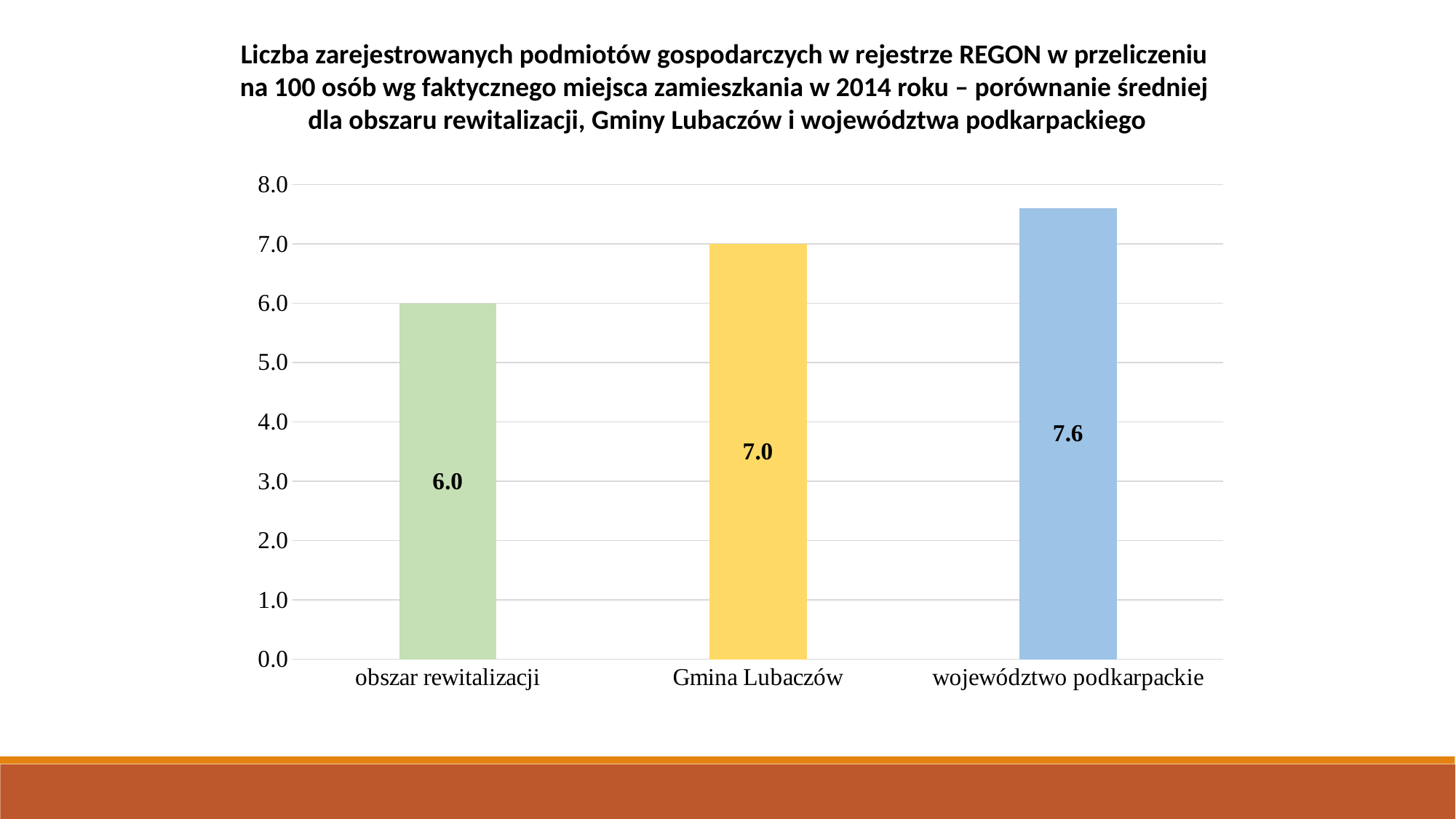
Do the values rise or fall from left to right along the x axis? rise Is the value for województwo podkarpackie greater or less than 7.0? greater What is the value for obszar rewitalizacji? 6.0 What kind of chart is shown on the slide? bar chart What is the difference between the values for województwo podkarpackie and obszar rewitalizacji? 1.6 How many categories are shown on the x axis? 3 Which category has the lowest value? obszar rewitalizacji What is the difference between the values for Gmina Lubaczów and obszar rewitalizacji? 1.0 Which category has the highest value? województwo podkarpackie What is the value for Gmina Lubaczów? 7.0 What is the value for województwo podkarpackie? 7.6 Which is larger, the value for Gmina Lubaczów or the value for obszar rewitalizacji? Gmina Lubaczów